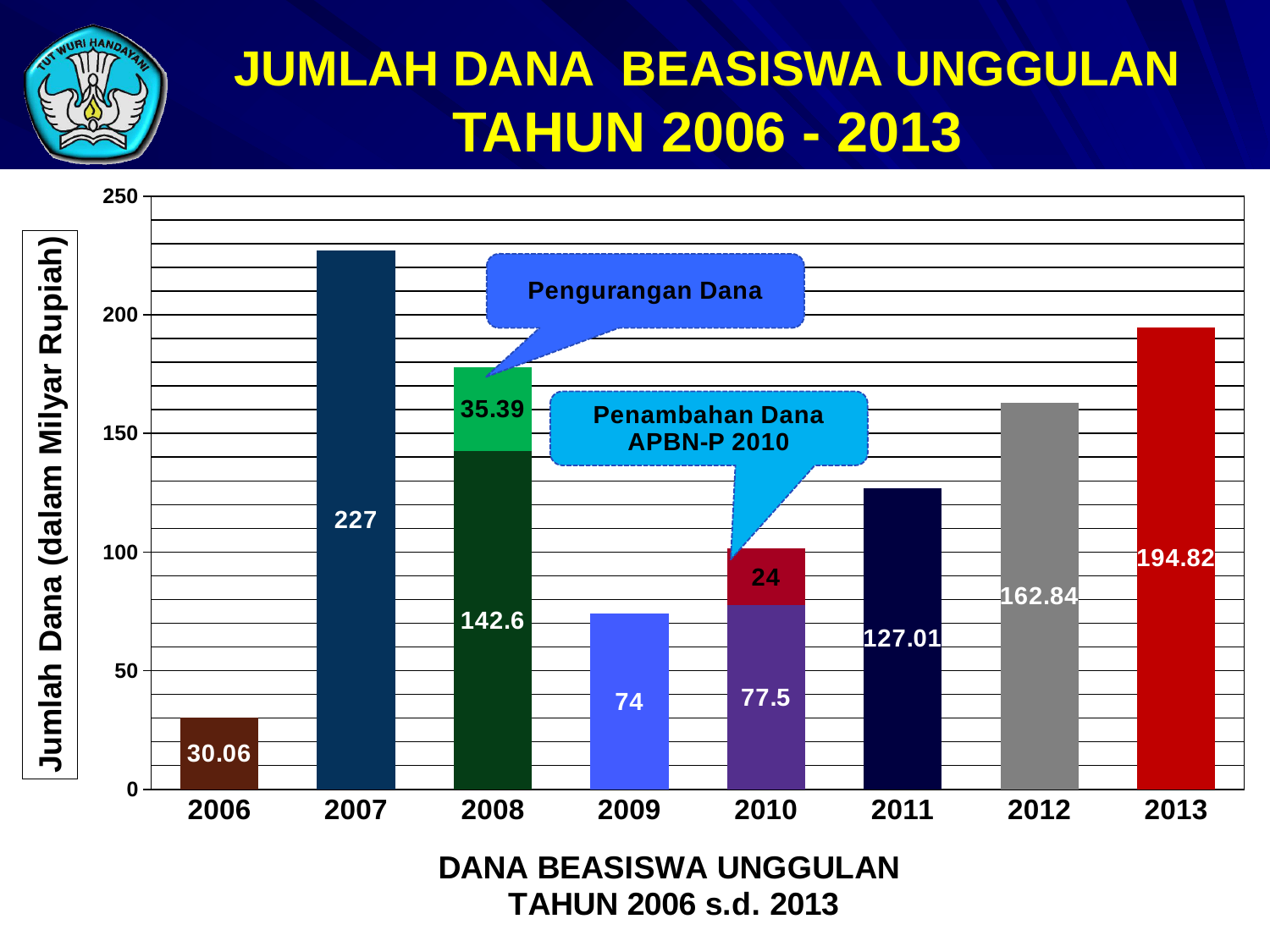
What is the difference between the values for 2012 and 2011? 35.83 What is the value for 2007? 227 How many years are shown on the x axis? 8 Which year has the lowest value? 2006 What is the value of the upper (red) segment of the 2010 bar? 24 What is the value for 2013? 194.82 What is the value for 2006? 30.06 What is the total of the stacked bar for 2010? 101.5 Which year has the highest value? 2007 What kind of chart is shown on the slide? Bar chart What is the value of the lower (dark green) segment of the 2008 bar? 142.6 Which is larger, the value for 2009 or the value for 2011? 2011